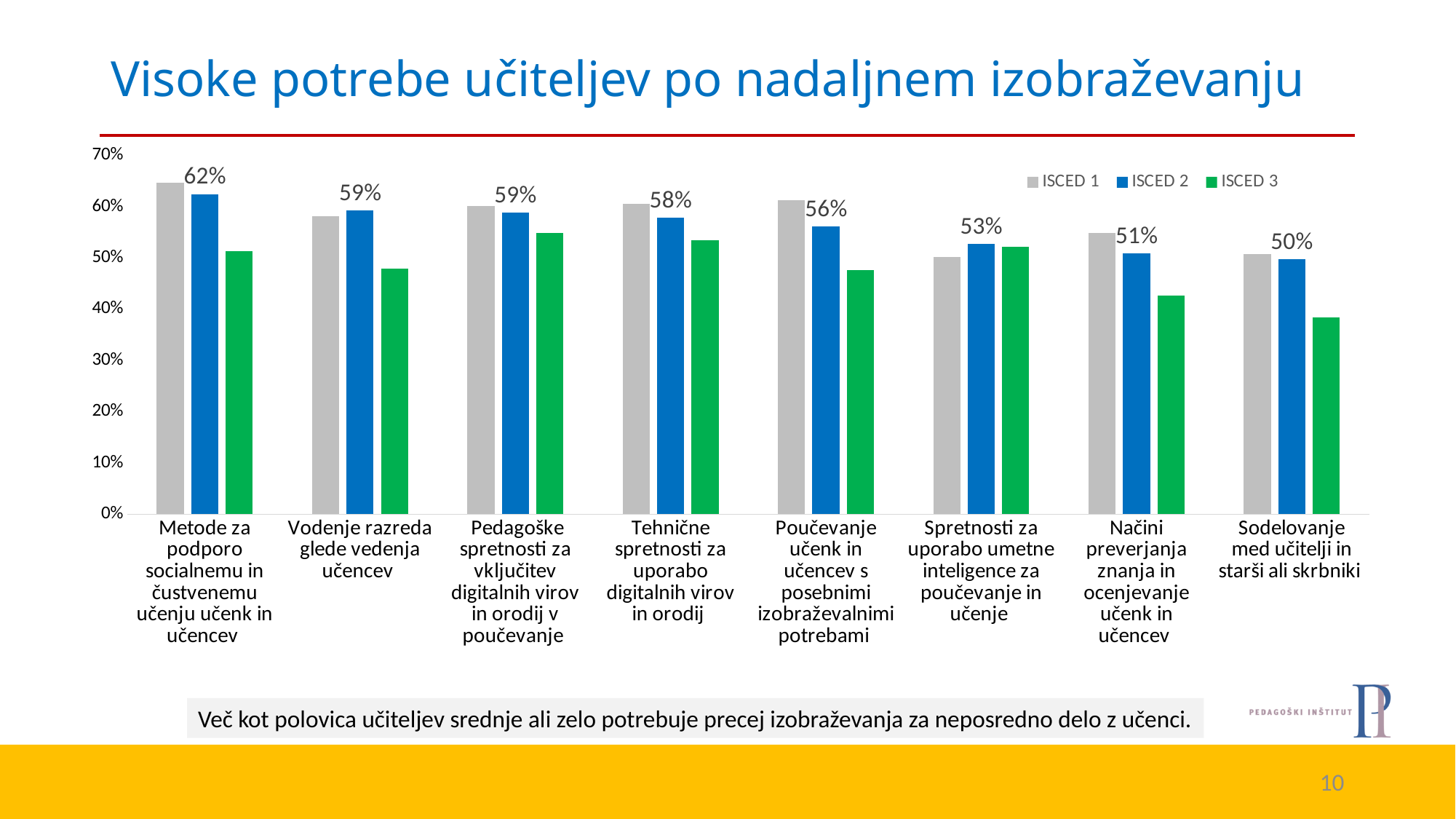
Which category has the lowest ISCED 2 value? Sodelovanje med učitelji in starši ali skrbniki Is the ISCED 3 value for "Sodelovanje med učitelji in starši ali skrbniki" greater or less than 50%? less Which category has the highest ISCED 2 value? Metode za podporo socialnemu in čustvenemu učenju učenk in učencev What is the ISCED 2 value for "Spretnosti za uporabo umetne inteligence za poučevanje in učenje"? 53% Is the ISCED 1 value for "Metode za podporo socialnemu in čustvenemu učenju učenk in učencev" greater or less than 60%? greater What is the difference between the ISCED 2 values for "Metode za podporo socialnemu in čustvenemu učenju učenk in učencev" and "Sodelovanje med učitelji in starši ali skrbniki"? 12 percentage points Do the ISCED 2 values rise or fall from left to right across the categories? fall What is the ISCED 2 value for "Sodelovanje med učitelji in starši ali skrbniki"? 50% Which has a larger ISCED 2 value: "Vodenje razreda glede vedenja učencev" or "Poučevanje učenk in učencev s posebnimi izobraževalnimi potrebami"? Vodenje razreda glede vedenja učencev How many series does the legend list? 3 How many categories are shown on the x axis of the chart? 8 What is the ISCED 2 value for "Metode za podporo socialnemu in čustvenemu učenju učenk in učencev"? 62%